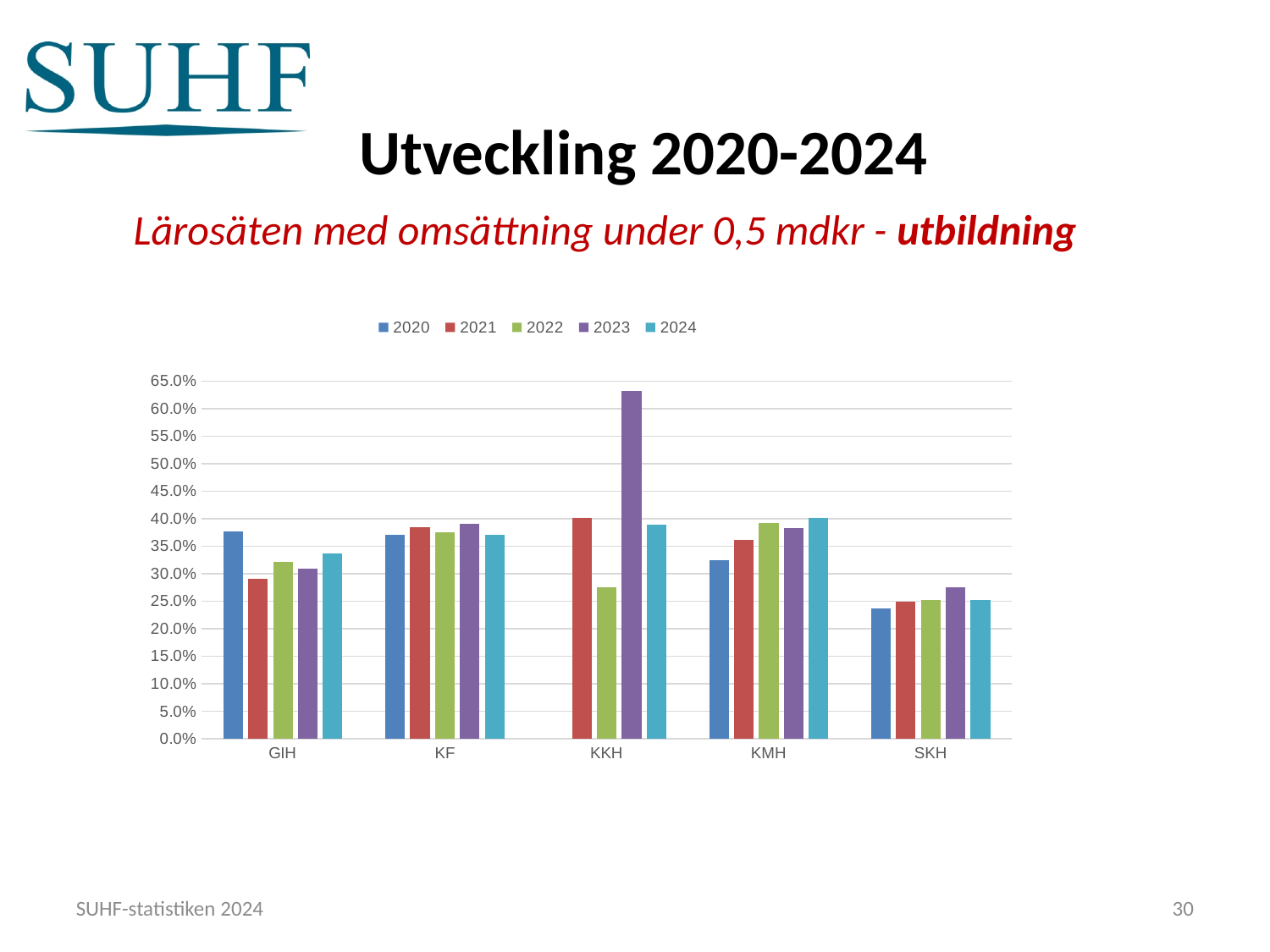
Which category has no bar for 2020? KKH For KKH, which year has the larger value, 2021 or 2022? 2021 Which category has the highest value for 2023? KKH Is the value for KMH in 2020 greater or less than 35.0%? less Is the value for SKH in 2020 greater or less than 25.0%? less What kind of chart is shown on the slide? bar chart How many series does the legend list? 5 For GIH, which year has the larger value, 2020 or 2021? 2020 Which category has the lowest value for 2020? SKH What is the first entry in the chart legend? 2020 How many categories (lärosäten) are shown on the x axis? 5 Is the value for KKH in 2023 greater or less than 60.0%? greater